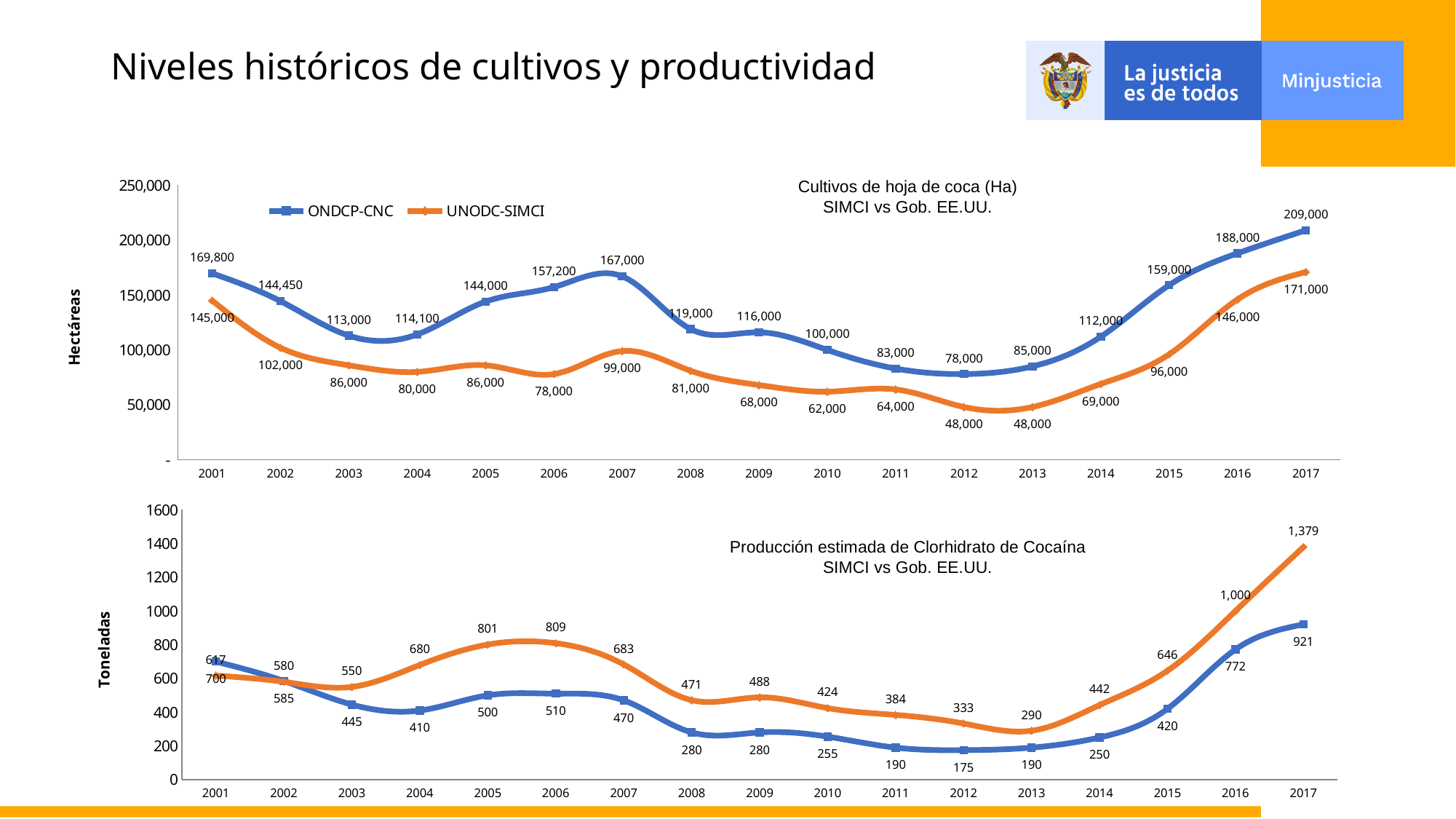
How many years are shown on the x axis of the chart 'Cultivos de hoja de coca (Ha)'? 17 In the chart 'Cultivos de hoja de coca (Ha)', what is the UNODC-SIMCI value for 2012? 48,000 In the chart 'Cultivos de hoja de coca (Ha)', what is the ONDCP-CNC value for 2017? 209,000 In the chart 'Producción estimada de Clorhidrato de Cocaína', what is the value of the orange line in 2017? 1,379 In the chart 'Cultivos de hoja de coca (Ha)', what is the difference between the ONDCP-CNC and UNODC-SIMCI values in 2017? 38,000 In the chart 'Cultivos de hoja de coca (Ha)', which series has the larger value in 2007, ONDCP-CNC or UNODC-SIMCI? ONDCP-CNC In the chart 'Producción estimada de Clorhidrato de Cocaína', what is the difference between the orange and blue values in 2017? 458 In the chart 'Producción estimada de Clorhidrato de Cocaína', what is the value of the blue line in 2012? 175 In the chart 'Cultivos de hoja de coca (Ha)', what is the lowest value of the UNODC-SIMCI series? 48,000 How many series does the legend of the chart 'Cultivos de hoja de coca (Ha)' list? 2 What kind of chart is 'Producción estimada de Clorhidrato de Cocaína'? Line chart In the chart 'Cultivos de hoja de coca (Ha)', in which year is the ONDCP-CNC series highest? 2017